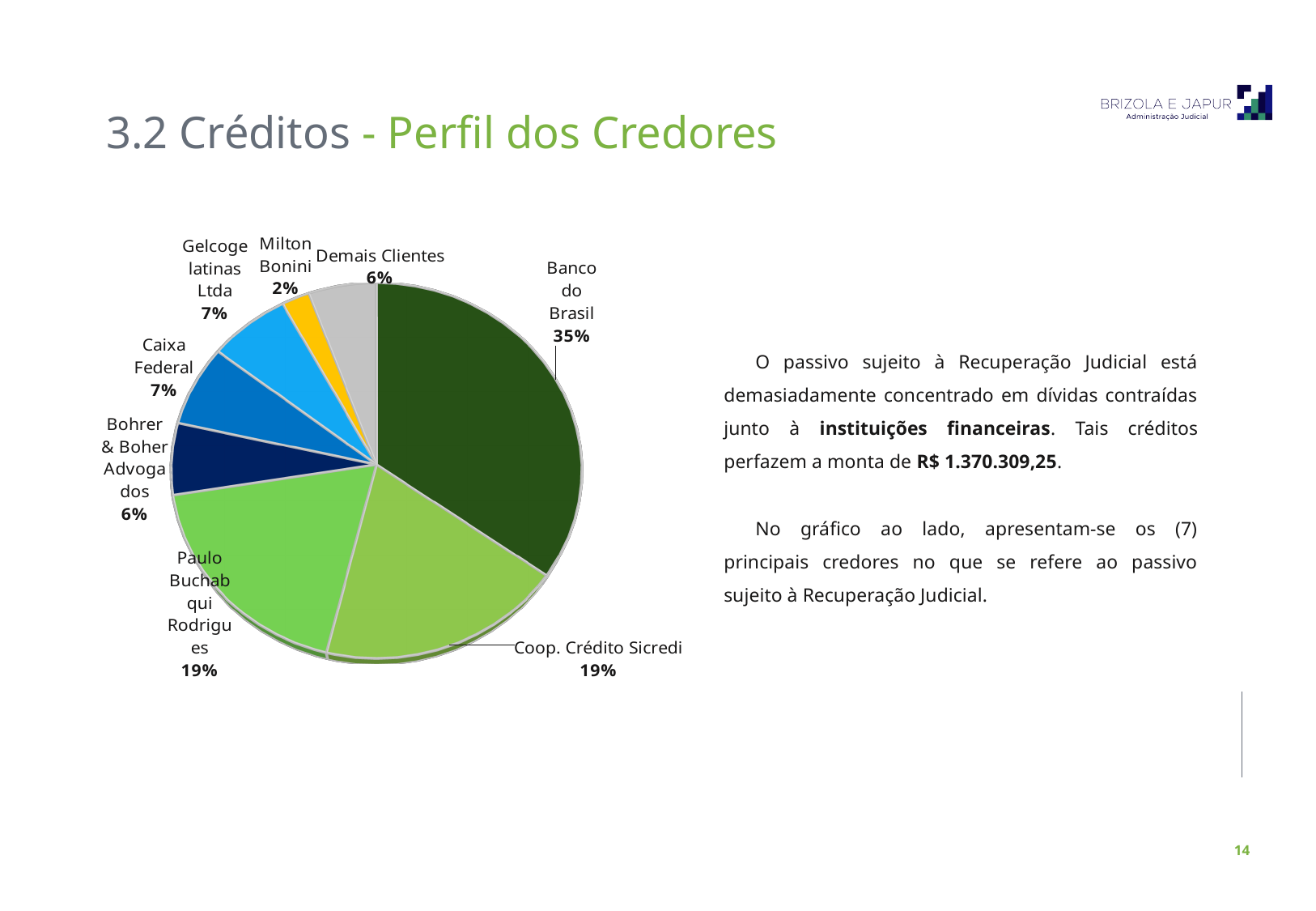
What share of the pie does Coop. Crédito Sicredi hold? 19% Which slice of the pie is the smallest? Milton Bonini What percentage is shown for Milton Bonini? 2% What kind of chart is shown on the slide? Pie chart What percentage is shown for Caixa Federal? 7% What is the difference in percentage points between Banco do Brasil and Coop. Crédito Sicredi? 16 How many slices does the pie chart have? 8 What percentage is shown for Demais Clientes? 6% What colour is the Banco do Brasil slice? Dark green What share of the pie does Banco do Brasil hold? 35% Which slice of the pie is the largest? Banco do Brasil Which is larger, the share for Caixa Federal or the share for Milton Bonini? Caixa Federal